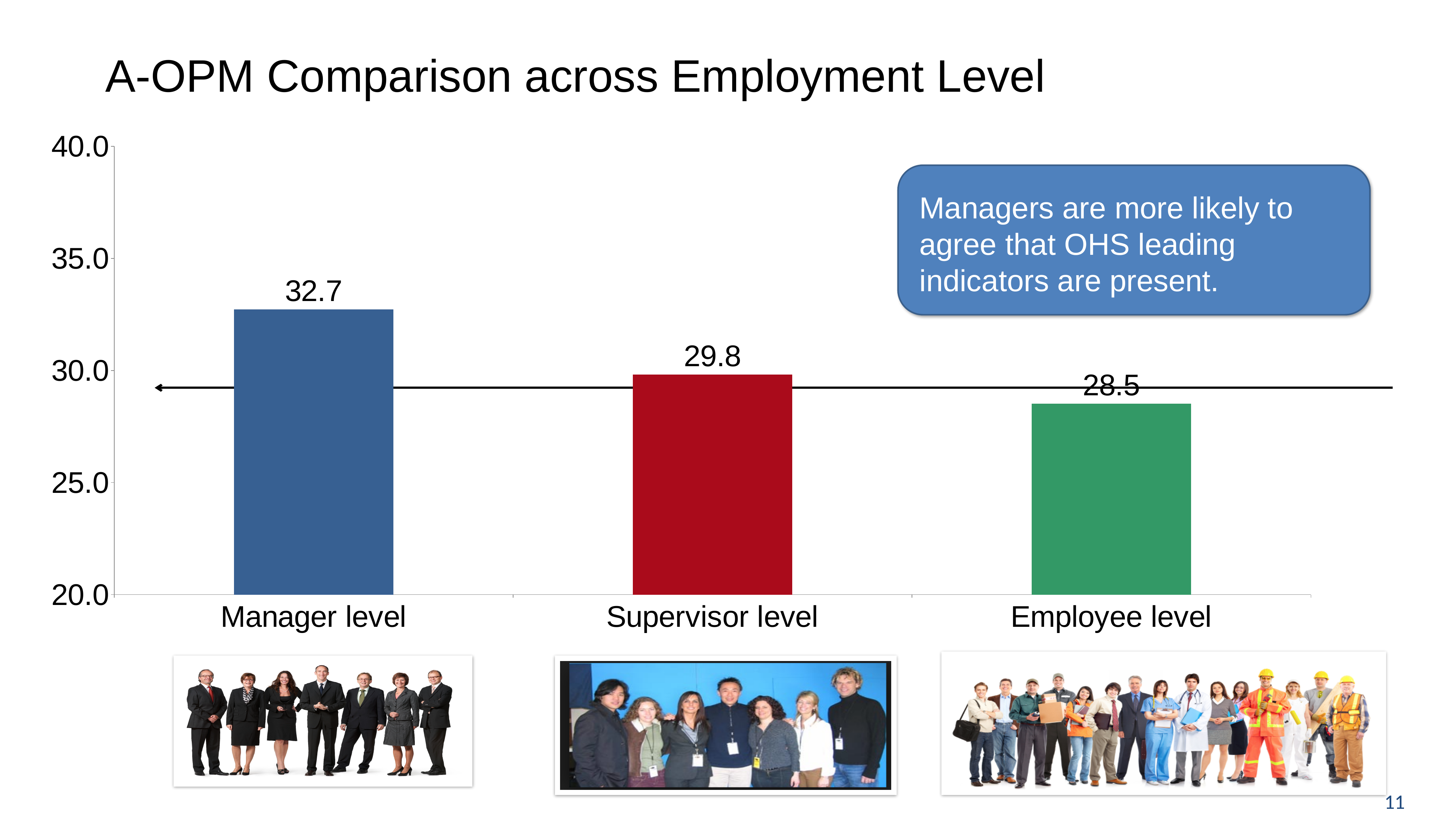
What is the value for Supervisor level? 29.8 Which is larger, the value for Supervisor level or Employee level? Supervisor level What kind of chart is shown on the slide? bar chart How many employment levels are shown in the chart? 3 Which employment level has the lowest value? Employee level What is the value for Employee level? 28.5 What is the value for Manager level? 32.7 Which employment level has the highest value? Manager level Do the values rise or fall from Manager level to Employee level? fall Is the value for Manager level greater or less than 30.0? greater What is the difference between the Manager level and Employee level values? 4.2 What is the difference between the Manager level and Supervisor level values? 2.9